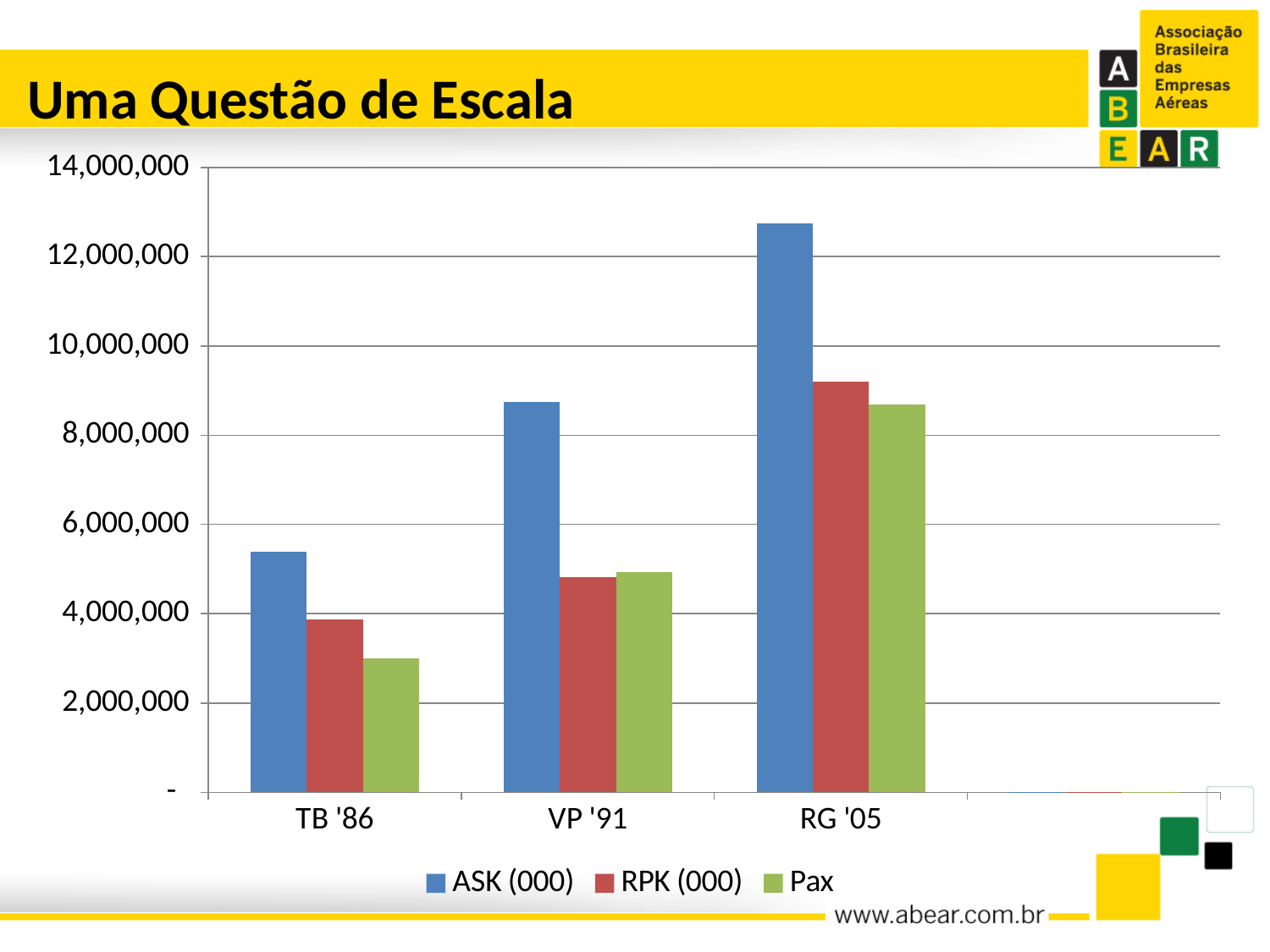
Which category has the lowest Pax value? TB '86 For RG '05, which is larger: RPK (000) or Pax? RPK (000) Is the RPK (000) value for TB '86 greater or less than 4,000,000? less How many series does the legend list? 3 Do the ASK (000) values rise or fall from TB '86 to RG '05? rise What kind of chart is shown on the slide? bar chart Is the Pax value for RG '05 greater or less than 8,000,000? greater Is the ASK (000) value for RG '05 greater or less than 12,000,000? greater Which has the larger ASK (000) value: TB '86 or VP '91? VP '91 Which category has the highest ASK (000) value? RG '05 How many category labels appear on the x axis? 3